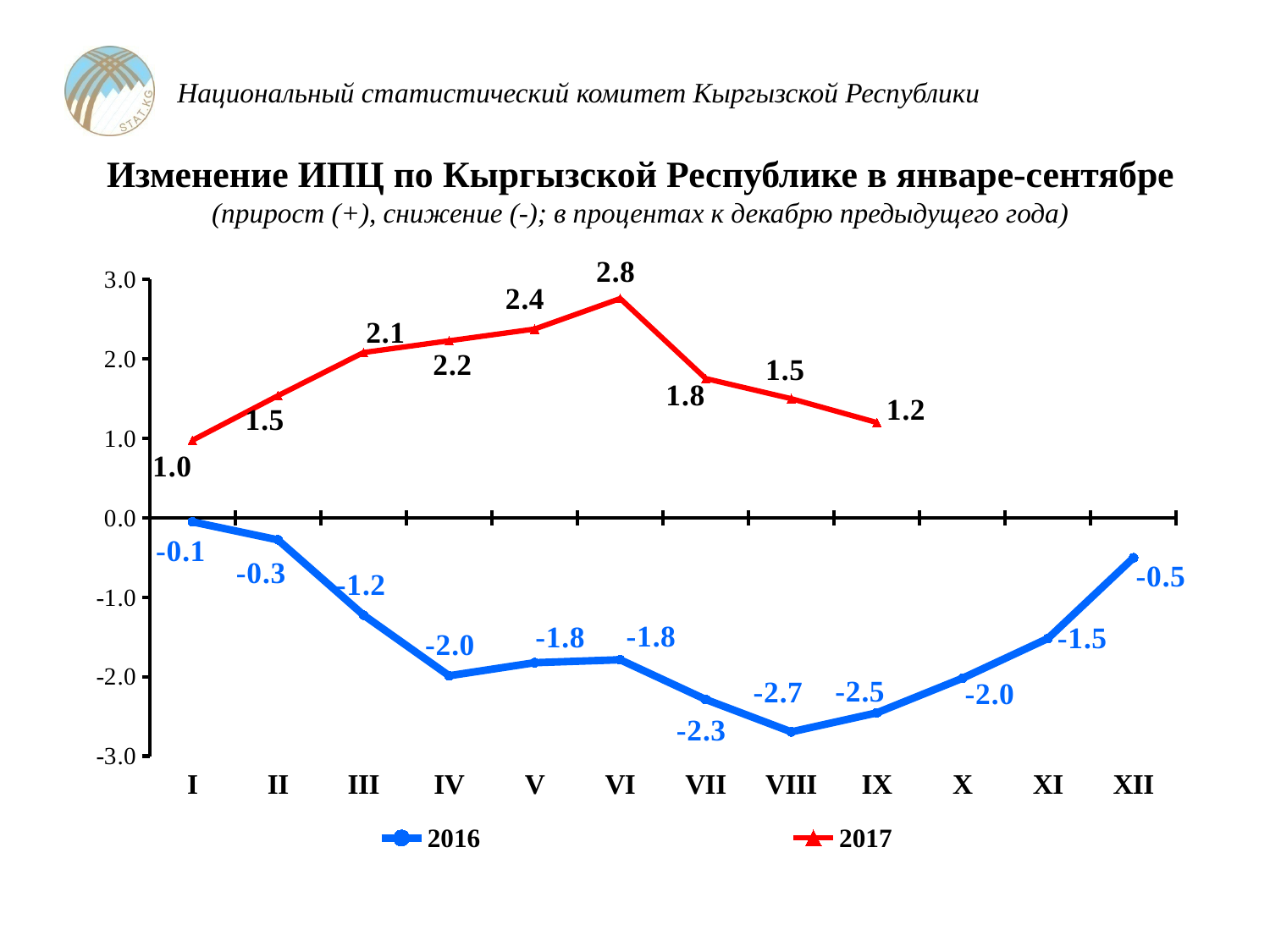
What is the value for 2016 in month VIII? -2.7 What colour is the line for the 2016 series? Blue What is the difference between the 2017 and 2016 values in month IV? 4.2 In which month does the 2016 series reach its lowest value? VIII Which series has the larger value in month III, 2016 or 2017? 2017 How many series does the legend list? 2 Does the 2017 series rise or fall from month VI to month IX? Fall What is the value for 2017 in month IX? 1.2 What kind of chart is shown on the slide? Line chart What is the value for 2017 in month VI? 2.8 In which month does the 2017 series reach its highest value? VI How many months have data points for the 2017 series? 9